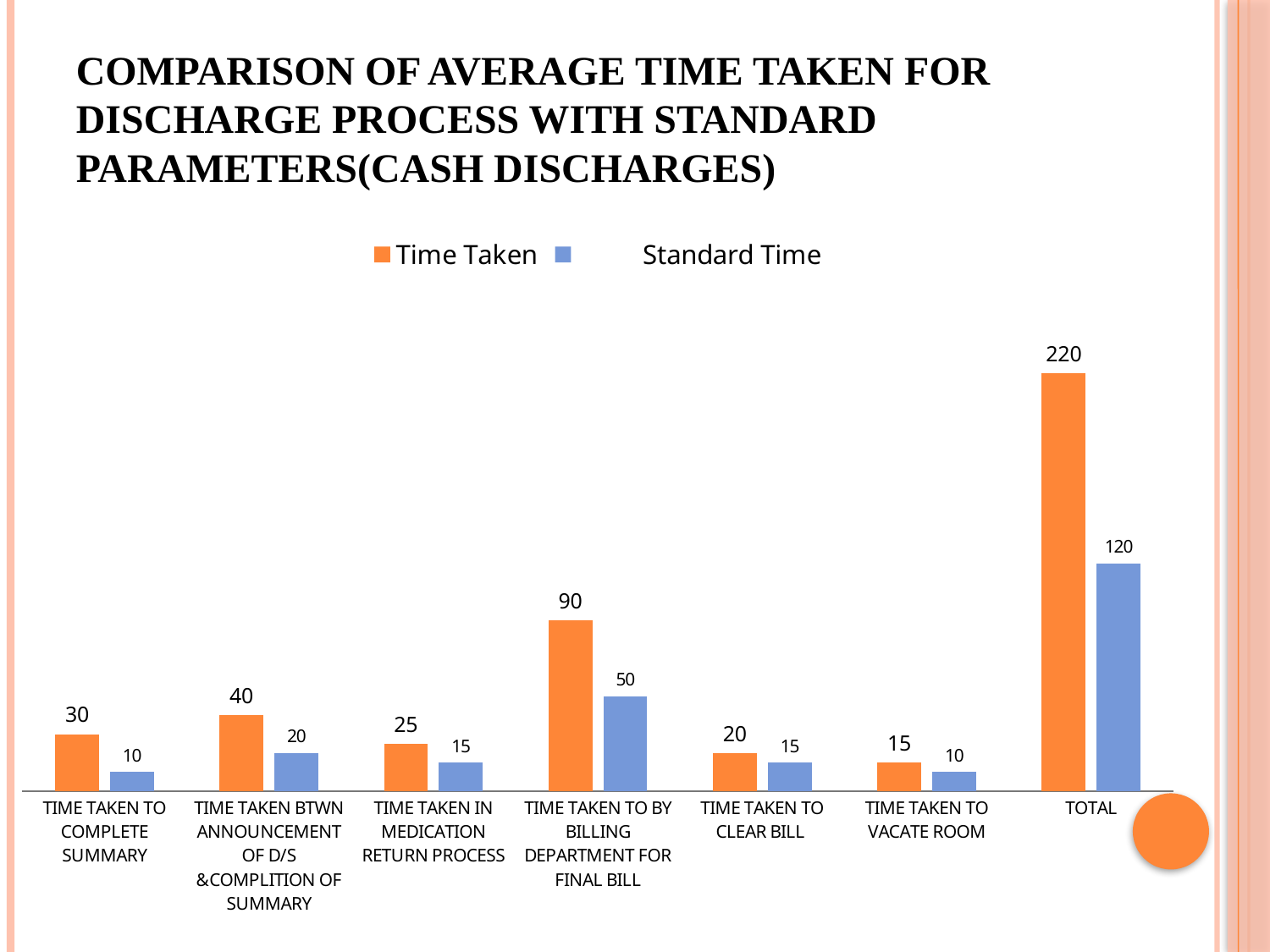
What is the difference between Time Taken and Standard Time for TIME TAKEN BTWN ANNOUNCEMENT OF D/S &COMPLITION OF SUMMARY? 20 What kind of chart is shown on the slide? Bar chart What is the difference between Time Taken and Standard Time for TOTAL? 100 How many categories are shown on the x axis? 7 What is the Time Taken value for TIME TAKEN TO COMPLETE SUMMARY? 30 Excluding TOTAL, which category has the highest Time Taken value? TIME TAKEN TO BY BILLING DEPARTMENT FOR FINAL BILL What is the Time Taken value for TOTAL? 220 What is the Standard Time value for TIME TAKEN TO VACATE ROOM? 10 What is the Standard Time value for TIME TAKEN TO BY BILLING DEPARTMENT FOR FINAL BILL? 50 Excluding TOTAL, which category has the lowest Time Taken value? TIME TAKEN TO VACATE ROOM How many series does the legend list? 2 Which is larger for TIME TAKEN IN MEDICATION RETURN PROCESS: Time Taken or Standard Time? Time Taken